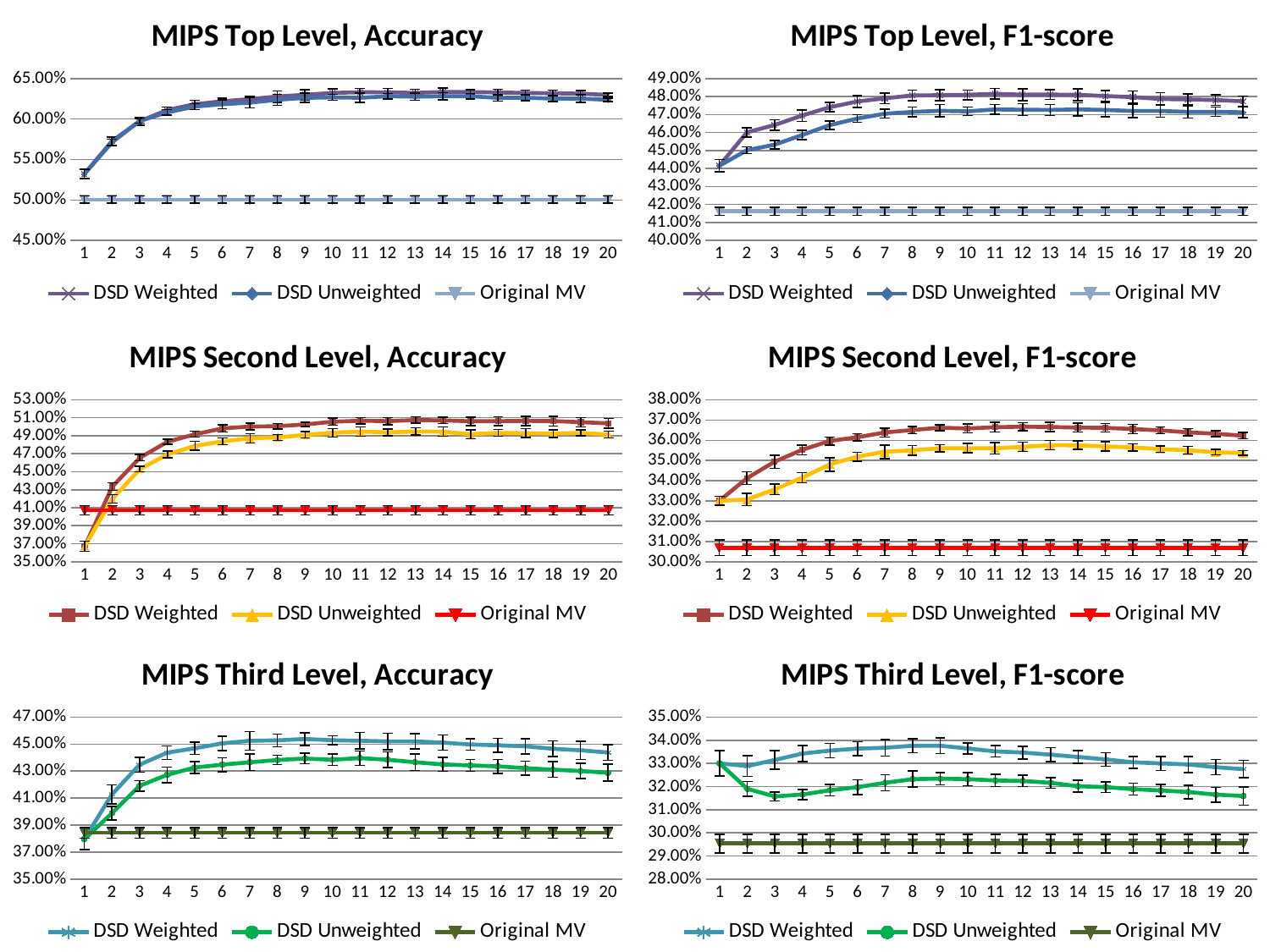
In the "MIPS Top Level, Accuracy" chart, does the DSD Weighted line rise or fall from x = 1 to x = 5? rise In the "MIPS Second Level, F1-score" chart, how many points are on the x axis? 20 In the "MIPS Third Level, Accuracy" chart, is the value for DSD Weighted at x = 9 greater or less than 43.00%? greater In the "MIPS Third Level, Accuracy" chart, which series has the lowest value at x = 20? Original MV What kind of chart is "MIPS Top Level, Accuracy"? line chart In the "MIPS Second Level, F1-score" chart, is the value for Original MV at x = 10 greater or less than 31.00%? less In the "MIPS Second Level, Accuracy" chart, which series has the larger value at x = 10, DSD Weighted or DSD Unweighted? DSD Weighted In the "MIPS Top Level, Accuracy" chart, is the value for DSD Weighted at x = 1 greater or less than 55.00%? less In the "MIPS Top Level, F1-score" chart, which series has the larger value at x = 1, DSD Weighted or Original MV? DSD Weighted In the "MIPS Third Level, F1-score" chart, does the DSD Unweighted line rise or fall from x = 1 to x = 3? fall In the "MIPS Top Level, Accuracy" chart, how many series does the legend list? 3